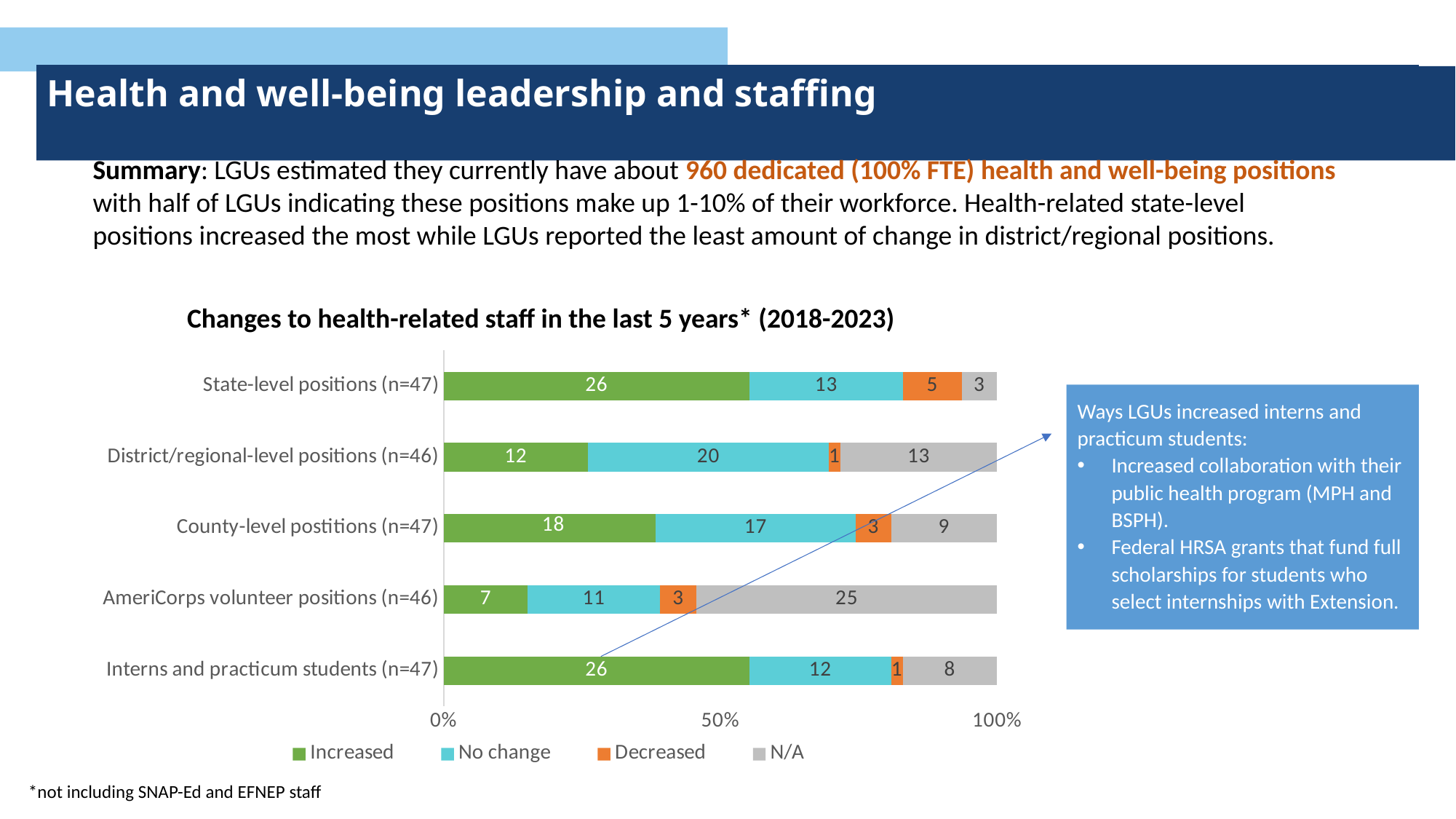
How many series does the legend list? 4 What is the 'Increased' value for State-level positions (n=47)? 26 What is the 'N/A' value for AmeriCorps volunteer positions (n=46)? 25 Which category has the lowest 'Increased' value? AmeriCorps volunteer positions (n=46) What is the 'No change' value for District/regional-level positions (n=46)? 20 What is the 'Decreased' value for County-level positions (n=47)? 3 Which is larger: the 'No change' value for County-level positions (n=47) or for Interns and practicum students (n=47)? County-level positions (n=47) What is the difference between the 'Increased' values for State-level positions (n=47) and District/regional-level positions (n=46)? 14 How many categories are shown on the y axis of the chart? 5 What kind of chart is shown on the slide? Stacked bar chart What is the total of the stacked bar for County-level positions (n=47)? 47 Which category has the highest 'N/A' value? AmeriCorps volunteer positions (n=46)